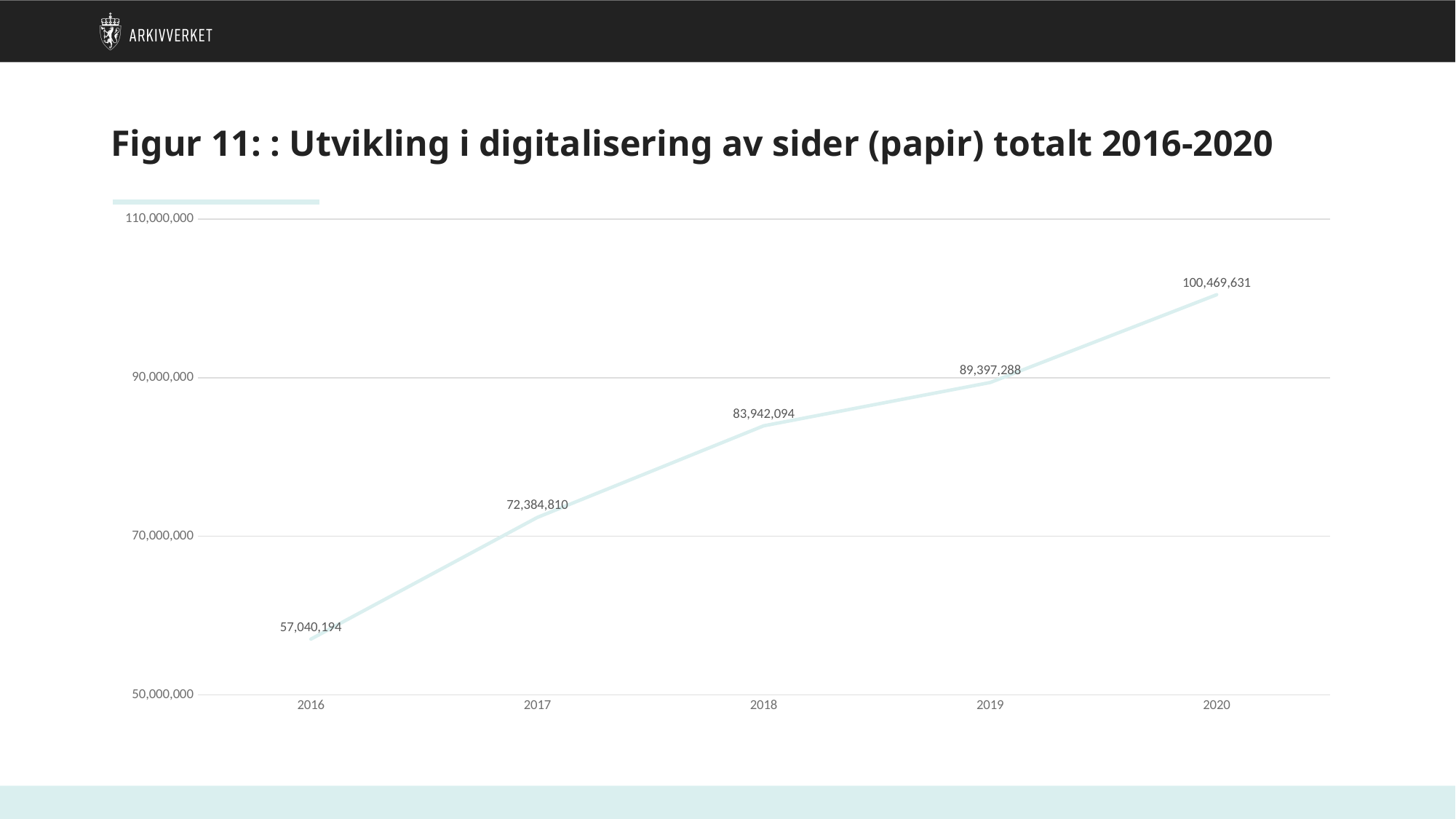
How many years are plotted on the chart? 5 What is the value for 2016? 57,040,194 What is the value for 2018? 83,942,094 What kind of chart is shown on the slide? line chart What is the difference between the values for 2020 and 2016? 43,429,437 What is the difference between the values for 2017 and 2016? 15,344,616 What is the value for 2020? 100,469,631 Is the value for 2019 greater or less than 90,000,000? less Which year has the lowest value? 2016 Which year has the highest value? 2020 Which is larger, the value for 2019 or the value for 2018? 2019 Do the values rise or fall from 2016 to 2020? rise